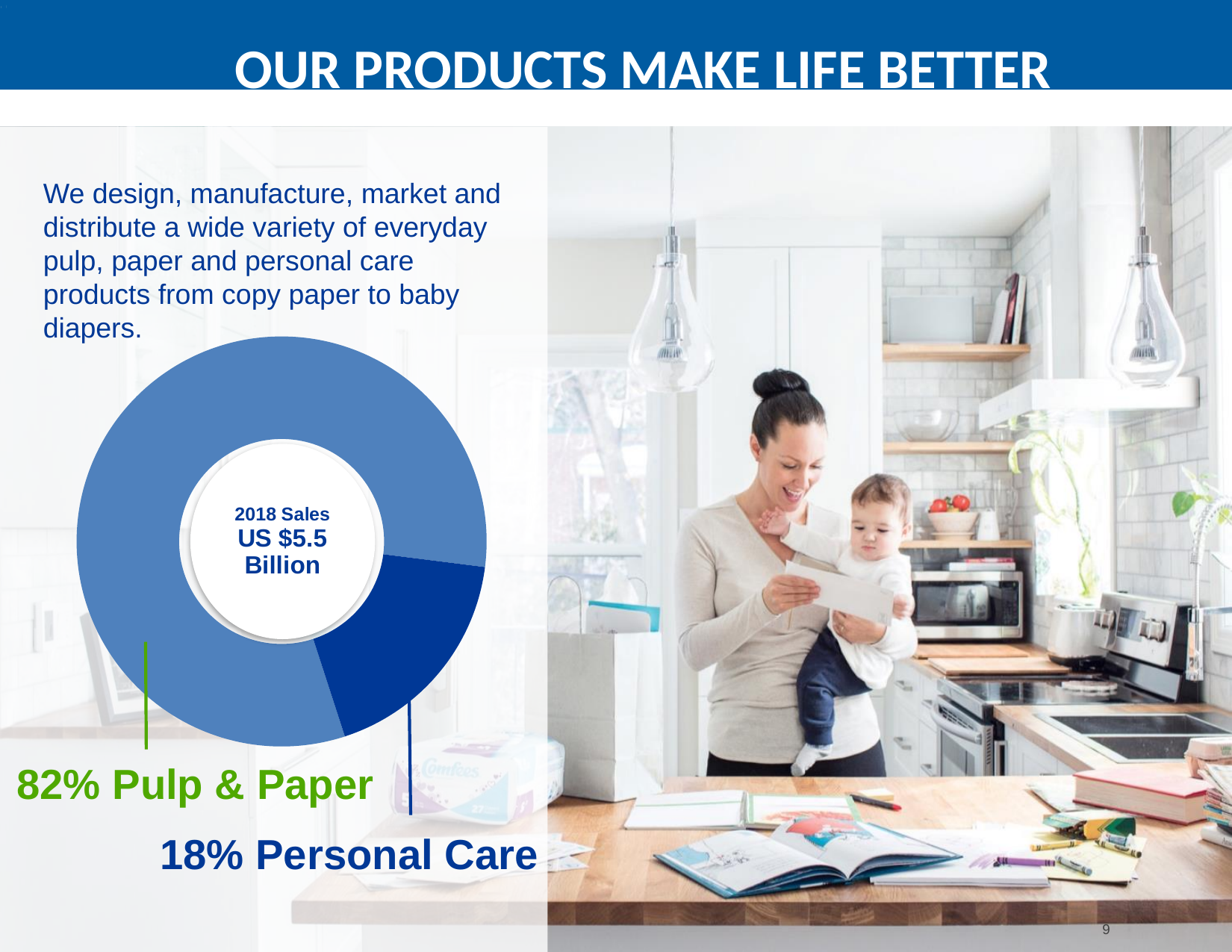
Which is larger, the Pulp & Paper share or the Personal Care share? Pulp & Paper What share of 2018 sales does Pulp & Paper represent? 82% What is the title of the slide containing the pie chart? OUR PRODUCTS MAKE LIFE BETTER Which segment is the smallest in the pie chart? Personal Care What kind of chart is shown on the slide? Doughnut chart How many segments does the pie chart have? 2 What is the difference in percentage points between the Pulp & Paper and Personal Care shares? 64 percentage points Which segment is the largest in the pie chart? Pulp & Paper Which year's sales does the pie chart represent? 2018 What share of 2018 sales does Personal Care represent? 18% What total 2018 sales figure is shown in the centre of the pie chart? US $5.5 Billion